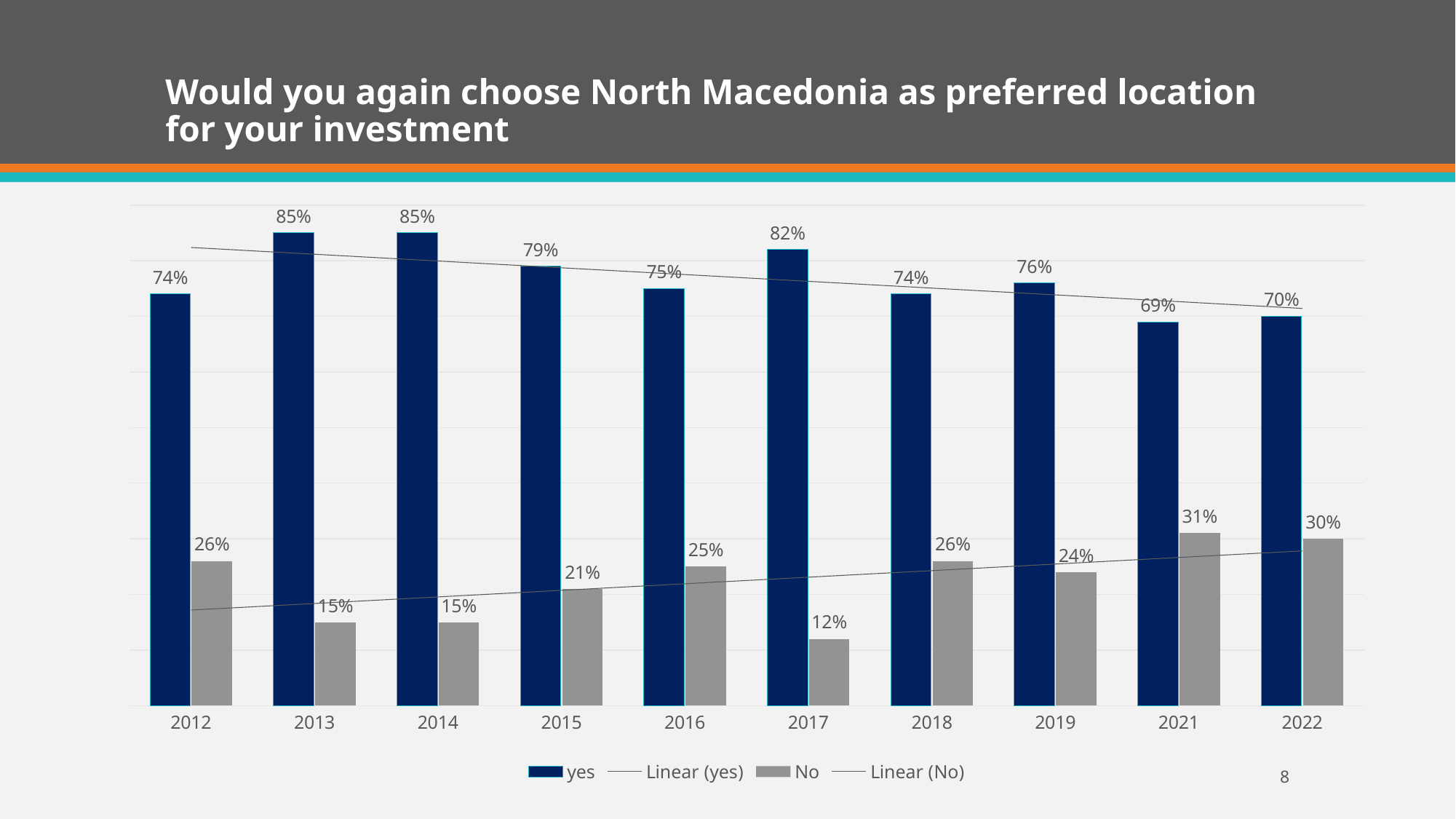
How many years are shown on the x axis? 10 What is the value for "yes" in 2022? 70% What is the difference between the "yes" values for 2013 and 2022? 15% Which is larger, the "No" value in 2016 or the "No" value in 2019? 2016 How many entries does the legend list? 4 What colour are the "yes" bars? Dark blue What is the value for "No" in 2021? 31% Does the linear trend line for "yes" rise or fall from 2012 to 2022? Fall What kind of chart is shown on the slide? Bar chart In which year is the "No" value highest? 2021 What is the value for "yes" in 2017? 82% In which year is the "No" value lowest? 2017